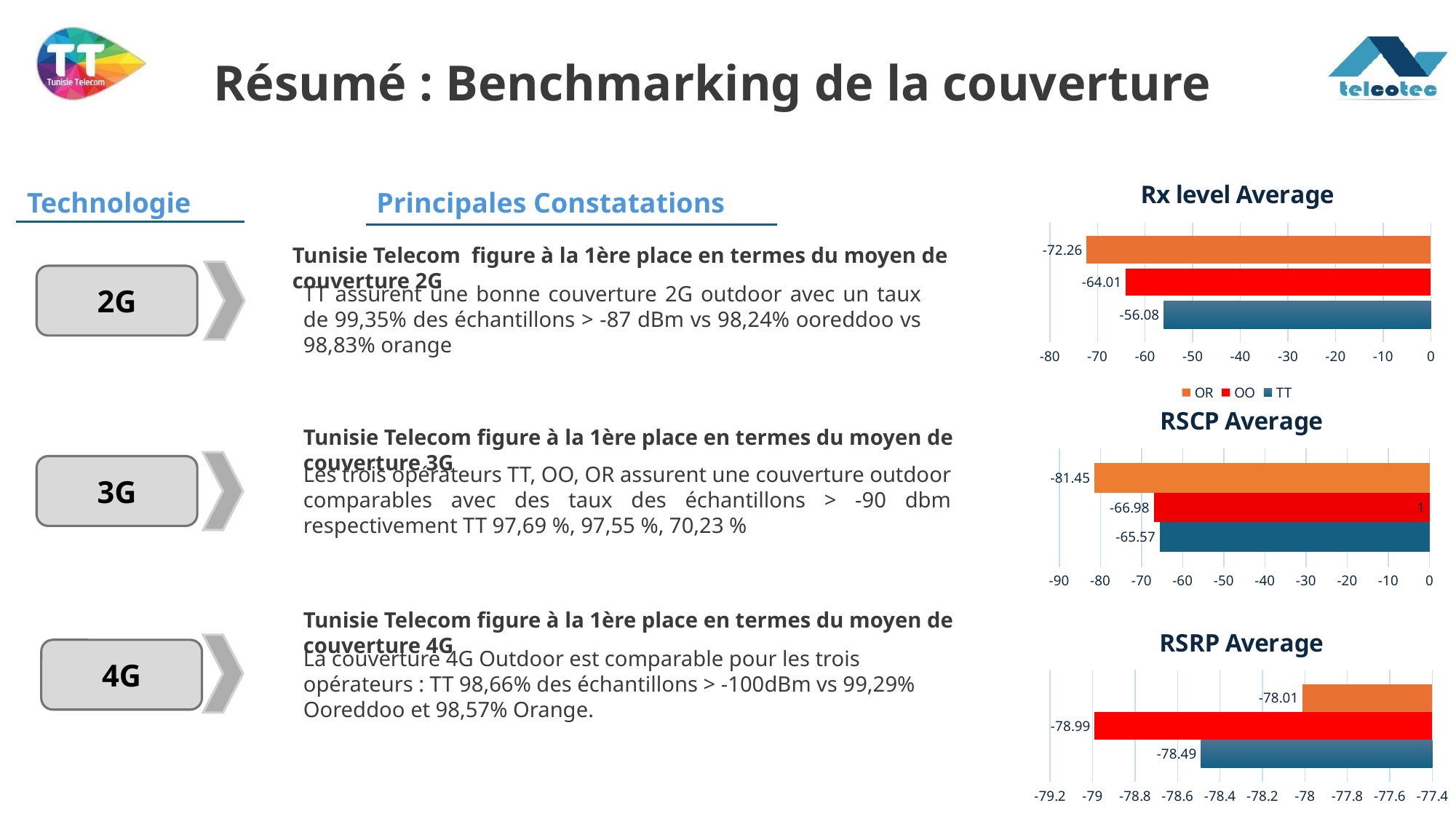
In the Rx level Average chart, what is the value for OR? -72.26 In the RSCP Average chart, is the value of the orange bar greater or less than -80? less How many bars are plotted in the RSRP Average chart? 3 In the RSRP Average chart, which bar has the highest (least negative) value? the orange bar (-78.01) In the RSCP Average chart, what is the value of the orange bar? -81.45 What type of chart is the RSCP Average chart? bar chart How many series does the legend under the Rx level Average chart list? 3 In the Rx level Average chart, what is the difference between the OO value and the TT value? 7.93 In the Rx level Average chart, what is the value for TT? -56.08 In the RSCP Average chart, what is the value of the blue bar? -65.57 In the Rx level Average chart, which series has the lowest (most negative) value? OR In the RSRP Average chart, what is the value of the red bar? -78.99